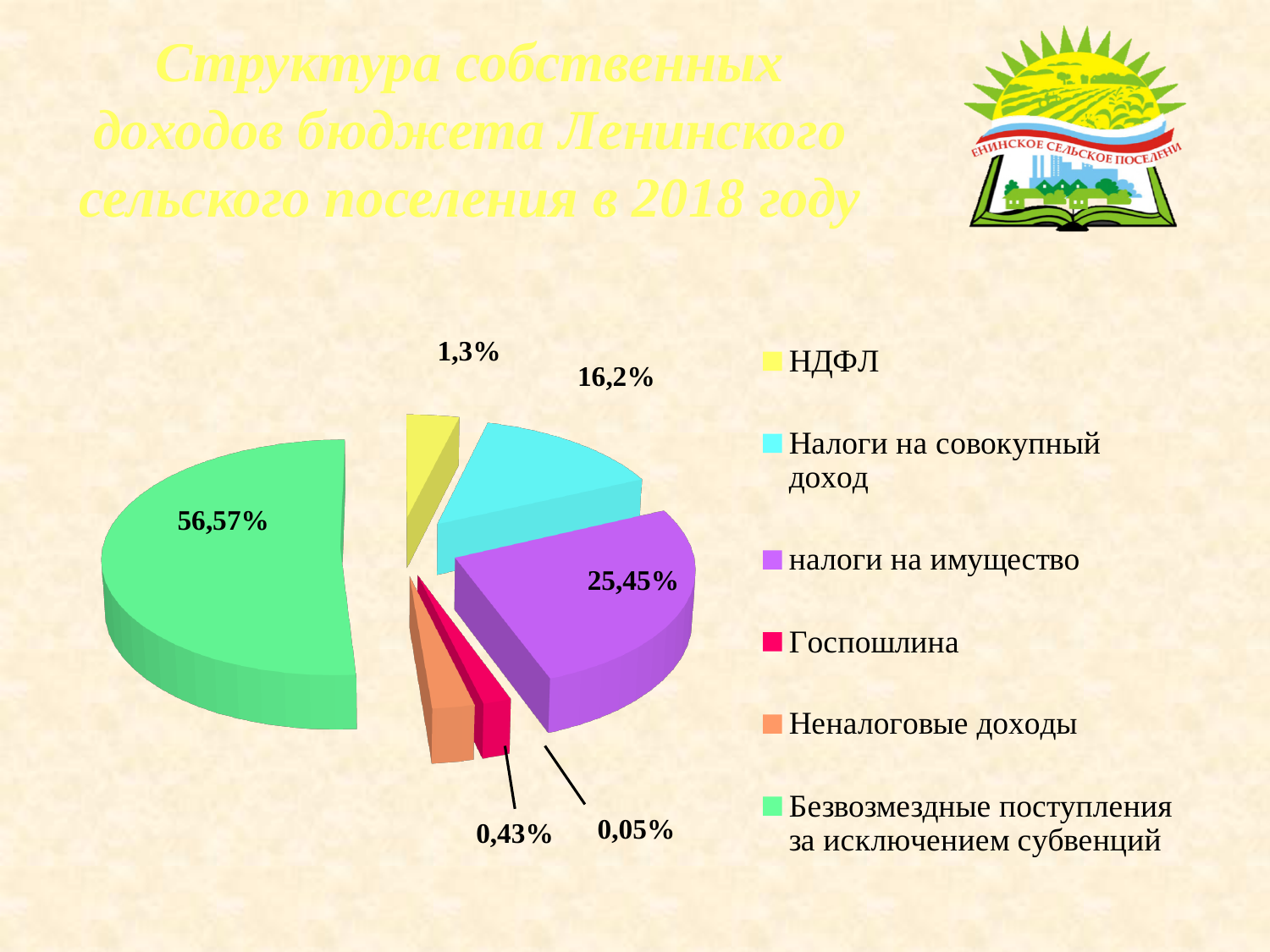
What is the value shown for Безвозмездные поступления за исключением субвенций? 56,57% What is the value shown for налоги на имущество? 25,45% What share of the pie does НДФЛ have? 1,3% How many categories does the legend list? 6 Which category has the smallest slice of the pie? Госпошлина What is the value shown for Налоги на совокупный доход? 16,2% Which is larger, the slice for налоги на имущество or the slice for Налоги на совокупный доход? налоги на имущество Which category has the largest slice of the pie? Безвозмездные поступления за исключением субвенций Which year does the chart title refer to? 2018 What colour is the slice for Безвозмездные поступления за исключением субвенций? Green What is the difference between the shares of налоги на имущество and Налоги на совокупный доход? 9,25% What kind of chart is shown on the slide? Pie chart